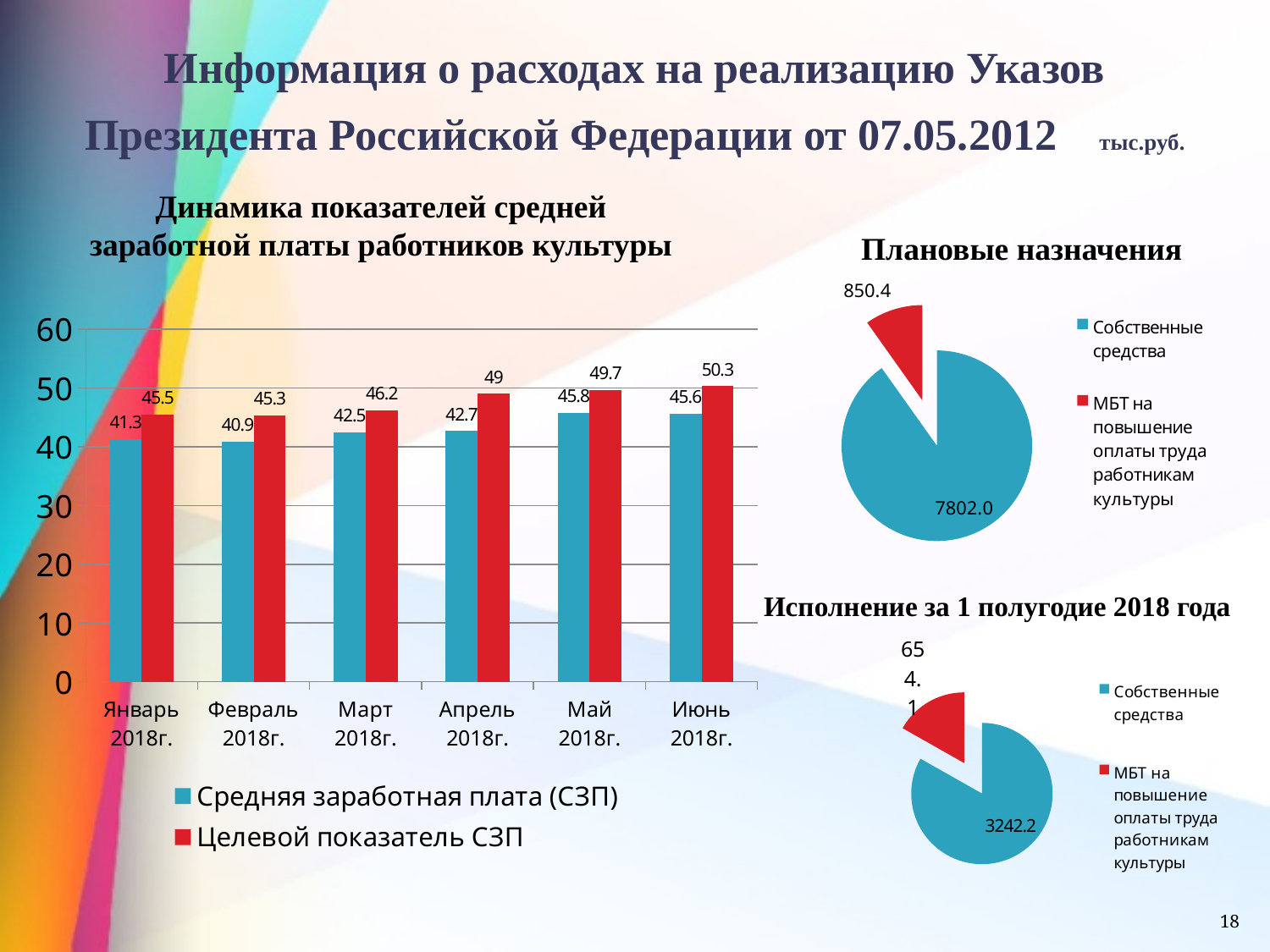
In the bar chart 'Динамика показателей средней заработной платы работников культуры', which month has the lowest value of 'Средняя заработная плата (СЗП)'? Февраль 2018г. In the pie chart 'Плановые назначения', what is the value of 'Собственные средства'? 7802.0 How many series does the legend of the bar chart 'Динамика показателей средней заработной платы работников культуры' list? 2 What kind of chart is 'Динамика показателей средней заработной платы работников культуры'? Bar chart In the bar chart 'Динамика показателей средней заработной платы работников культуры', what is the value of 'Целевой показатель СЗП' for Июнь 2018г.? 50.3 In the pie chart 'Исполнение за 1 полугодие 2018 года', what is the value of 'Собственные средства'? 3242.2 In the bar chart 'Динамика показателей средней заработной платы работников культуры', which month has the highest value of 'Целевой показатель СЗП'? Июнь 2018г. In the bar chart 'Динамика показателей средней заработной платы работников культуры', does 'Целевой показатель СЗП' generally rise or fall from Январь to Июнь 2018г.? Rise How many months are shown on the x axis of the bar chart 'Динамика показателей средней заработной платы работников культуры'? 6 In the bar chart 'Динамика показателей средней заработной платы работников культуры', what is the value of 'Средняя заработная плата (СЗП)' for Январь 2018г.? 41.3 In the bar chart 'Динамика показателей средней заработной платы работников культуры', which is larger for Май 2018г.: 'Средняя заработная плата (СЗП)' or 'Целевой показатель СЗП'? Целевой показатель СЗП In the bar chart 'Динамика показателей средней заработной платы работников культуры', what is the difference between 'Целевой показатель СЗП' and 'Средняя заработная плата (СЗП)' for Апрель 2018г.? 6.3